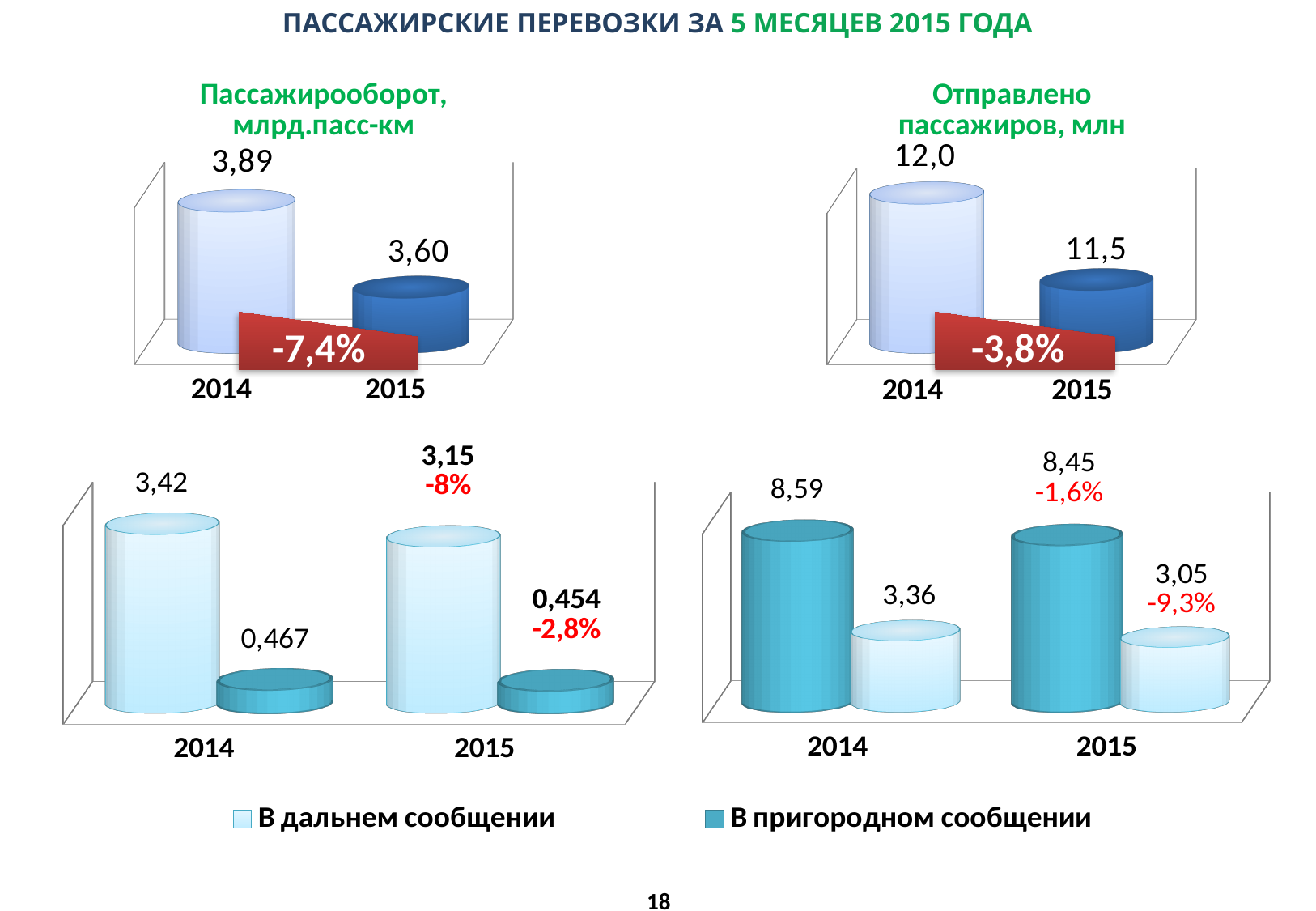
In the top-right chart 'Отправлено пассажиров, млн', what is the difference between the 2014 and 2015 values? 0,5 In the top-left chart 'Пассажирооборот, млрд.пасс-км', what is the difference between the 2014 and 2015 values? 0,29 In the top-left chart 'Пассажирооборот, млрд.пасс-км', what is the value for 2014? 3,89 In the bottom-right chart, which series has the larger value in 2014: 'В дальнем сообщении' or 'В пригородном сообщении'? В пригородном сообщении In the top-right chart 'Отправлено пассажиров, млн', what percentage change is shown between 2014 and 2015? -3,8% In the bottom-left chart, what is the value for 'В пригородном сообщении' in 2014? 0,467 How many series does the legend at the bottom of the slide list? 2 In the bottom-right chart, what percentage change is shown for 'В дальнем сообщении' in 2015? -9,3% In the top-right chart 'Отправлено пассажиров, млн', what is the value for 2014? 12,0 In the bottom-right chart, what is the value for 'В пригородном сообщении' in 2015? 8,45 In the top-left chart 'Пассажирооборот, млрд.пасс-км', what is the value for 2015? 3,60 In the bottom-left chart, what is the value for 'В дальнем сообщении' in 2015? 3,15